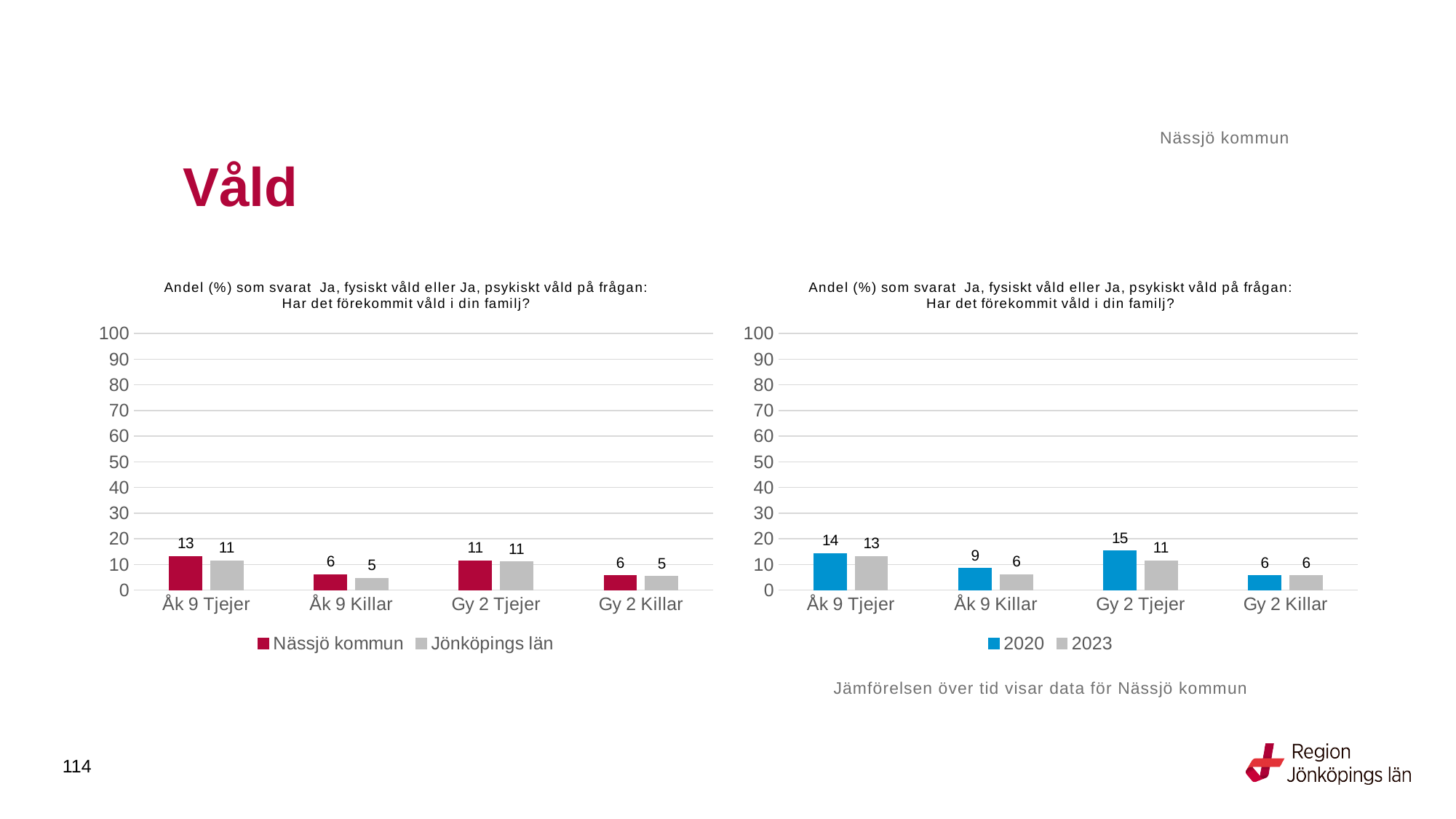
In the right chart, what is the value for 2020 for Gy 2 Tjejer? 15 In the left chart, what is the value for Jönköpings län for Gy 2 Killar? 5 In the right chart, what is the difference between the 2020 and 2023 values for Gy 2 Tjejer? 4 In the right chart, which category has the highest value for 2020? Gy 2 Tjejer In the left chart, what is the value for Nässjö kommun for Åk 9 Tjejer? 13 In the left chart, which is larger for Åk 9 Tjejer: Nässjö kommun or Jönköpings län? Nässjö kommun What kind of chart is the left chart? Bar chart How many categories are shown on the x axis of the left chart? 4 How many series does the legend of the right chart list? 2 In the right chart, is the value for 2020 for Åk 9 Tjejer greater or less than 20? less In the left chart, which category has the lowest value for Jönköpings län? Åk 9 Killar and Gy 2 Killar (both 5) In the right chart, what is the value for 2023 for Åk 9 Killar? 6